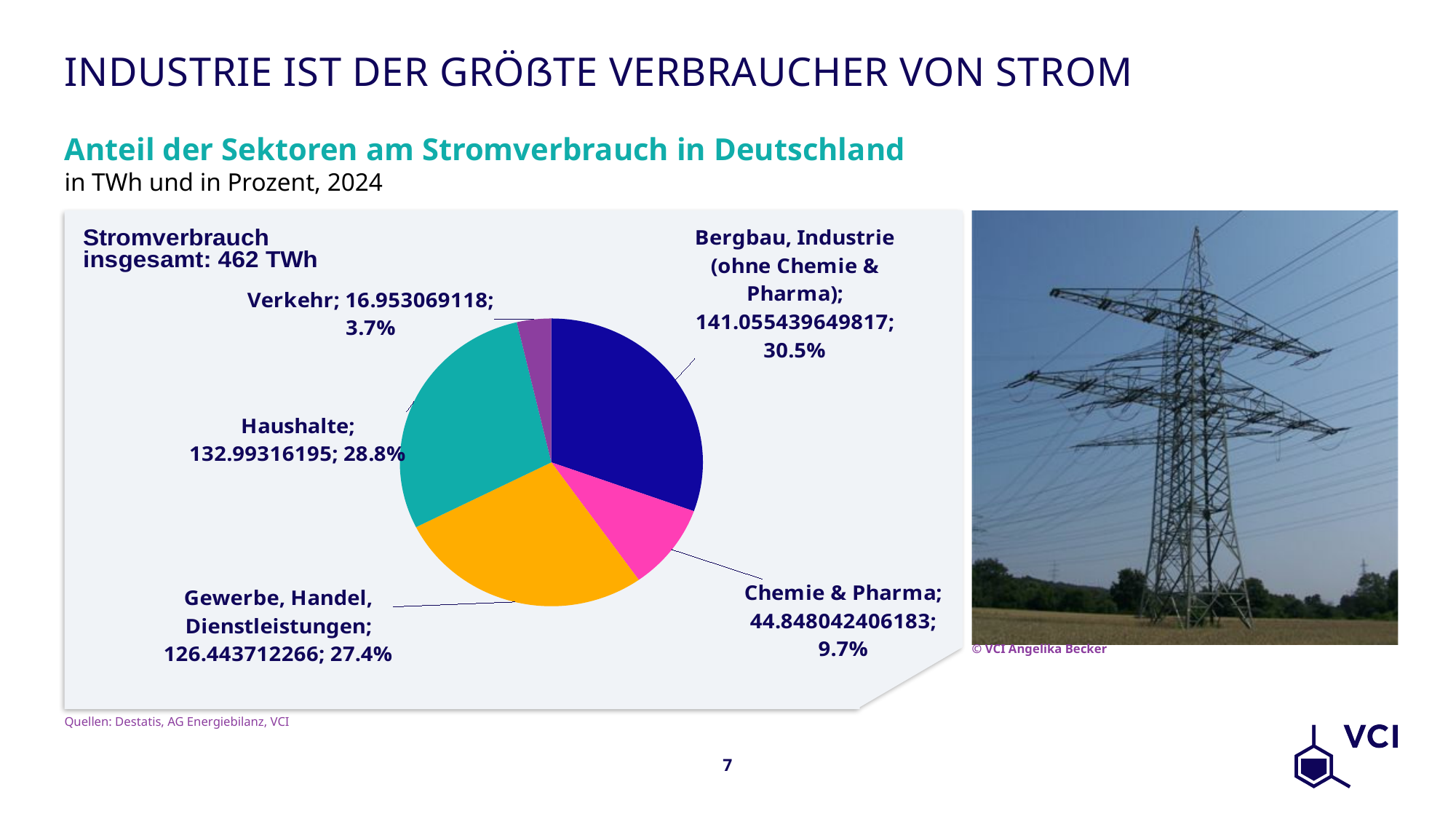
What share of the pie does Verkehr account for? 3.7% How many sectors (slices) does the pie chart show? 5 What kind of chart is shown on the slide? pie chart Which has the larger share: Haushalte or Gewerbe, Handel, Dienstleistungen? Haushalte What is the difference in percentage points between the shares of Bergbau, Industrie (ohne Chemie & Pharma) and Chemie & Pharma? 20.8 percentage points What percentage is shown for Bergbau, Industrie (ohne Chemie & Pharma)? 30.5% What share of electricity consumption does the Haushalte slice represent? 28.8% What total electricity consumption (Stromverbrauch insgesamt) is stated on the chart? 462 TWh What is the value in TWh shown for Chemie & Pharma? 44.848042406183 Which sector has the smallest share of electricity consumption? Verkehr What value in TWh is shown for Gewerbe, Handel, Dienstleistungen? 126.443712266 Which sector has the largest share of electricity consumption? Bergbau, Industrie (ohne Chemie & Pharma)